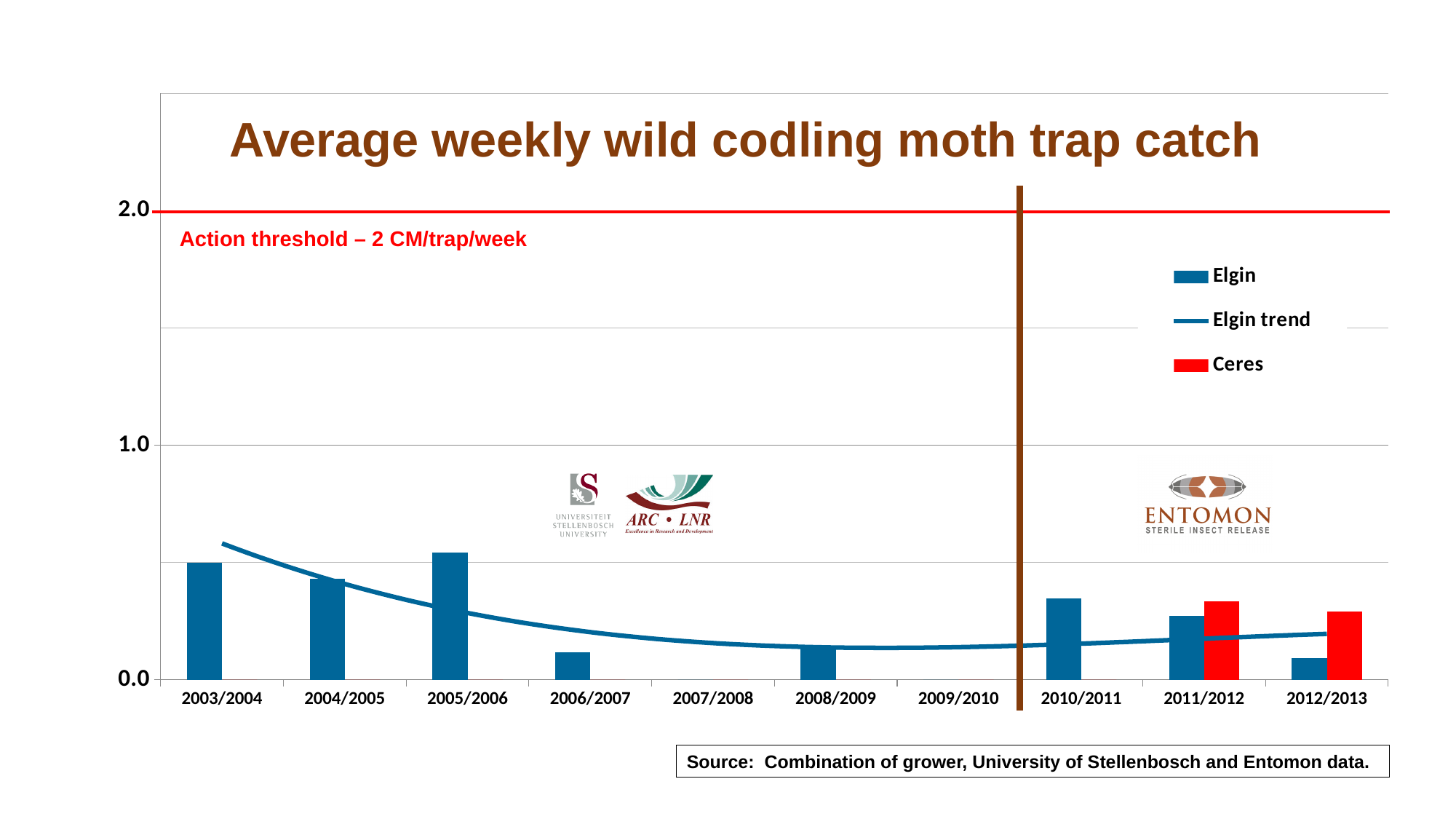
Does the Elgin trend line rise or fall from 2003/2004 to 2008/2009? fall What is the action threshold shown by the red line? 2 CM/trap/week Which is larger, the Elgin value for 2003/2004 or the Elgin value for 2006/2007? 2003/2004 What kind of chart is shown on the slide? Bar chart For how many seasons are Ceres values plotted? 2 Is the Ceres value for 2012/2013 greater or less than 1.0? less How many seasons are shown on the x axis? 10 Which is larger for 2012/2013, the Elgin value or the Ceres value? Ceres How many series does the legend list? 3 Which series are listed in the legend? Elgin, Elgin trend, Ceres Is the Elgin value for 2005/2006 greater or less than 1.0? less What is the title of the chart? Average weekly wild codling moth trap catch